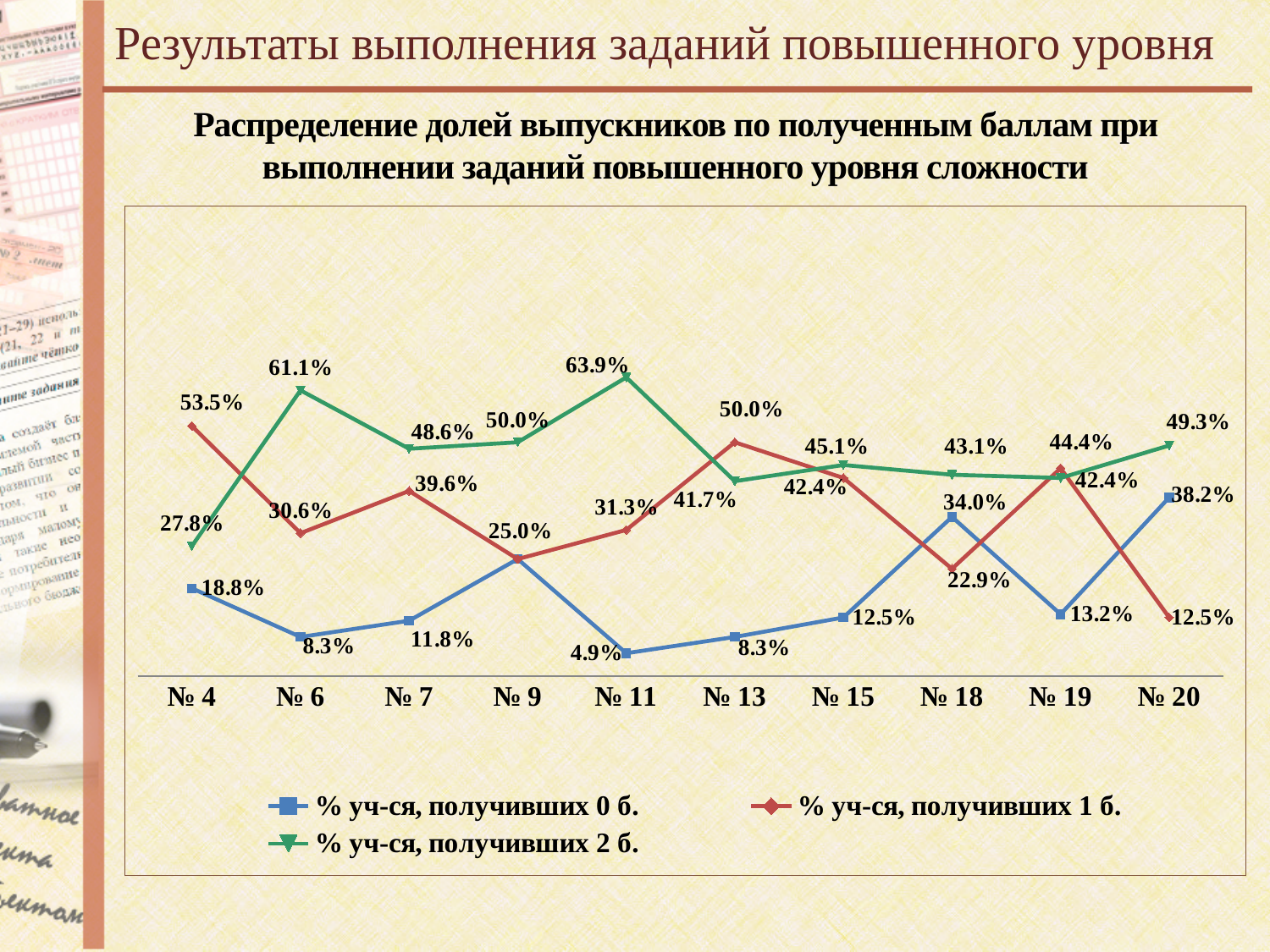
What colour is the line for '% уч-ся, получивших 2 б.'? green How many task categories are shown on the x axis? 10 For № 20, which series has the larger value: '% уч-ся, получивших 0 б.' or '% уч-ся, получивших 1 б.'? % уч-ся, получивших 0 б. How many series does the legend list? 3 Which task has the lowest value in the series '% уч-ся, получивших 1 б.'? № 20 What type of chart is shown on the slide? line chart Which task has the highest value in the series '% уч-ся, получивших 2 б.'? № 11 What is the value for № 4 in the series '% уч-ся, получивших 1 б.'? 53.5% Which task has the lowest value in the series '% уч-ся, получивших 0 б.'? № 11 What is the difference between the '% уч-ся, получивших 2 б.' value for № 6 and the '% уч-ся, получивших 0 б.' value for № 6? 52.8% What is the value for № 11 in the series '% уч-ся, получивших 2 б.'? 63.9% What is the value for № 18 in the series '% уч-ся, получивших 0 б.'? 34.0%